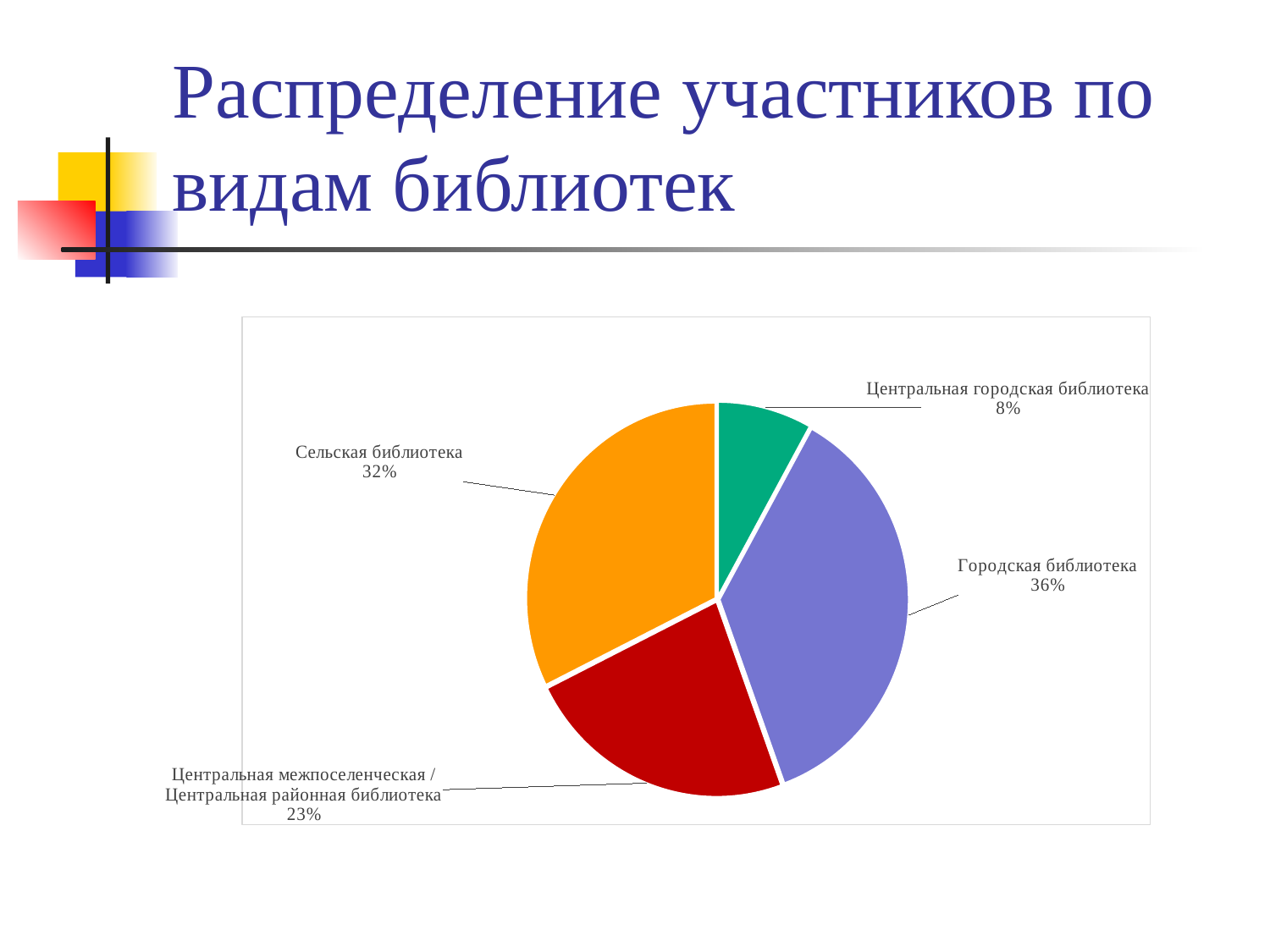
What is the title of the slide? Распределение участников по видам библиотек What type of chart is shown on the slide? Pie chart What share of participants is from Городская библиотека? 36% Which has a larger share: Сельская библиотека or Центральная межпоселенческая / Центральная районная библиотека? Сельская библиотека Which library type has the largest share of participants? Городская библиотека What is the difference in percentage points between Городская библиотека and Сельская библиотека? 4 What share of participants is from Центральная межпоселенческая / Центральная районная библиотека? 23% What share of participants is from Сельская библиотека? 32% What is the difference in percentage points between Сельская библиотека and Центральная городская библиотека? 24 How many slices does the pie chart have? 4 Which library type has the smallest share of participants? Центральная городская библиотека